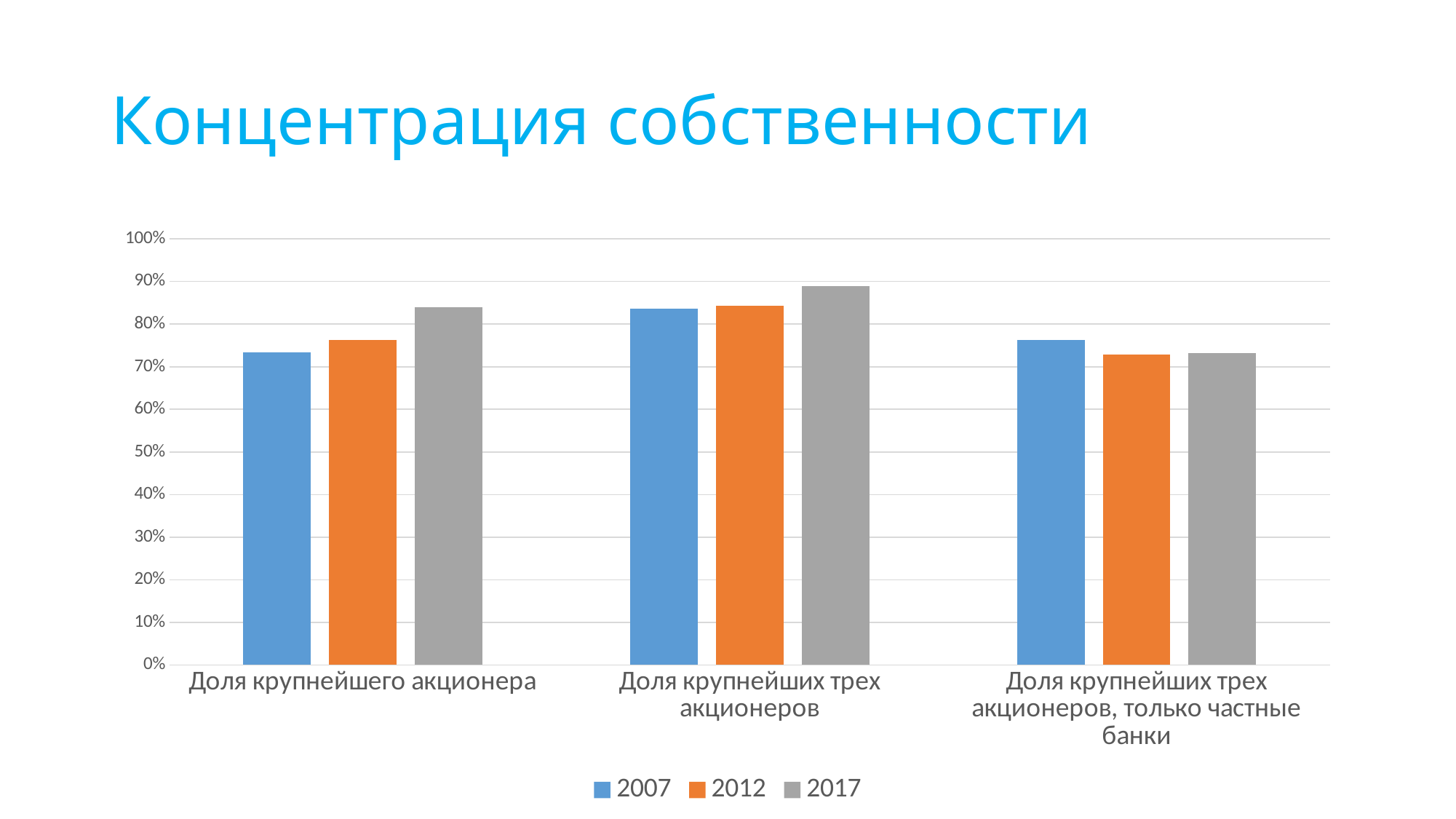
Which year has the highest value in "Доля крупнейших трех акционеров, только частные банки"? 2007 Is the value for 2012 in "Доля крупнейших трех акционеров, только частные банки" greater or less than 70%? greater Which year has the highest value in "Доля крупнейших трех акционеров"? 2017 Is the value for 2007 in "Доля крупнейшего акционера" greater or less than 80%? less Is the value for 2017 in "Доля крупнейших трех акционеров" greater or less than 80%? greater In "Доля крупнейшего акционера", which is larger: the value for 2007 or the value for 2017? 2017 What kind of chart is shown on the slide? bar chart Do the values for "Доля крупнейшего акционера" rise or fall from 2007 to 2017? rise How many series does the legend list? 3 What is the title of the slide? Концентрация собственности How many categories are shown on the x axis? 3